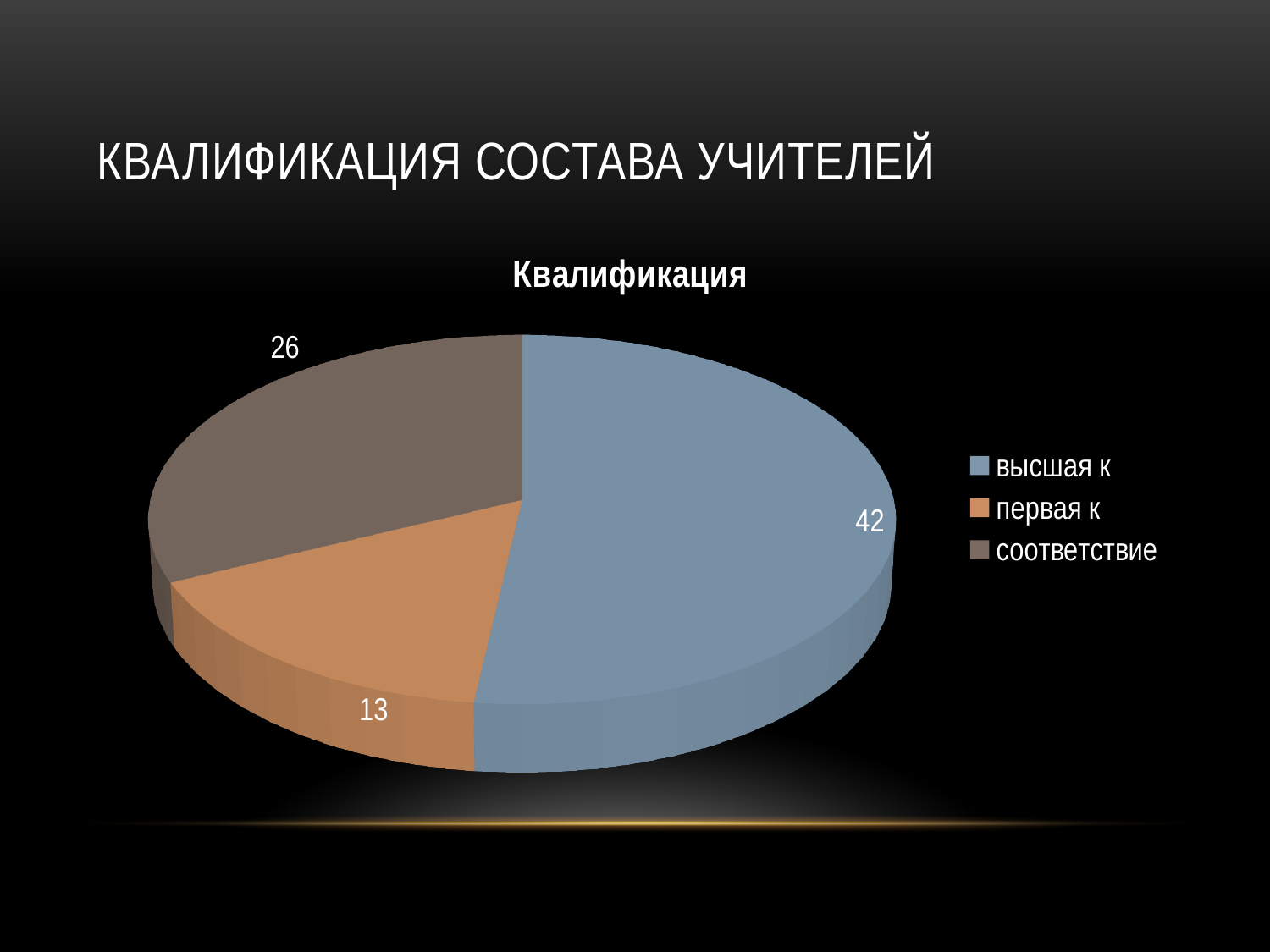
Which category has the smallest slice? первая к What is the value for высшая к? 42 How many categories does the pie chart have? 3 What is the value for первая к? 13 What is the value for соответствие? 26 Which category has the largest slice? высшая к What is the difference between the values for высшая к and соответствие? 16 Which is larger, the value for соответствие or the value for первая к? соответствие What is the difference between the values for соответствие and первая к? 13 What is the title of the chart? Квалификация What is the total of all slices in the pie chart? 81 What type of chart is shown on the slide? pie chart